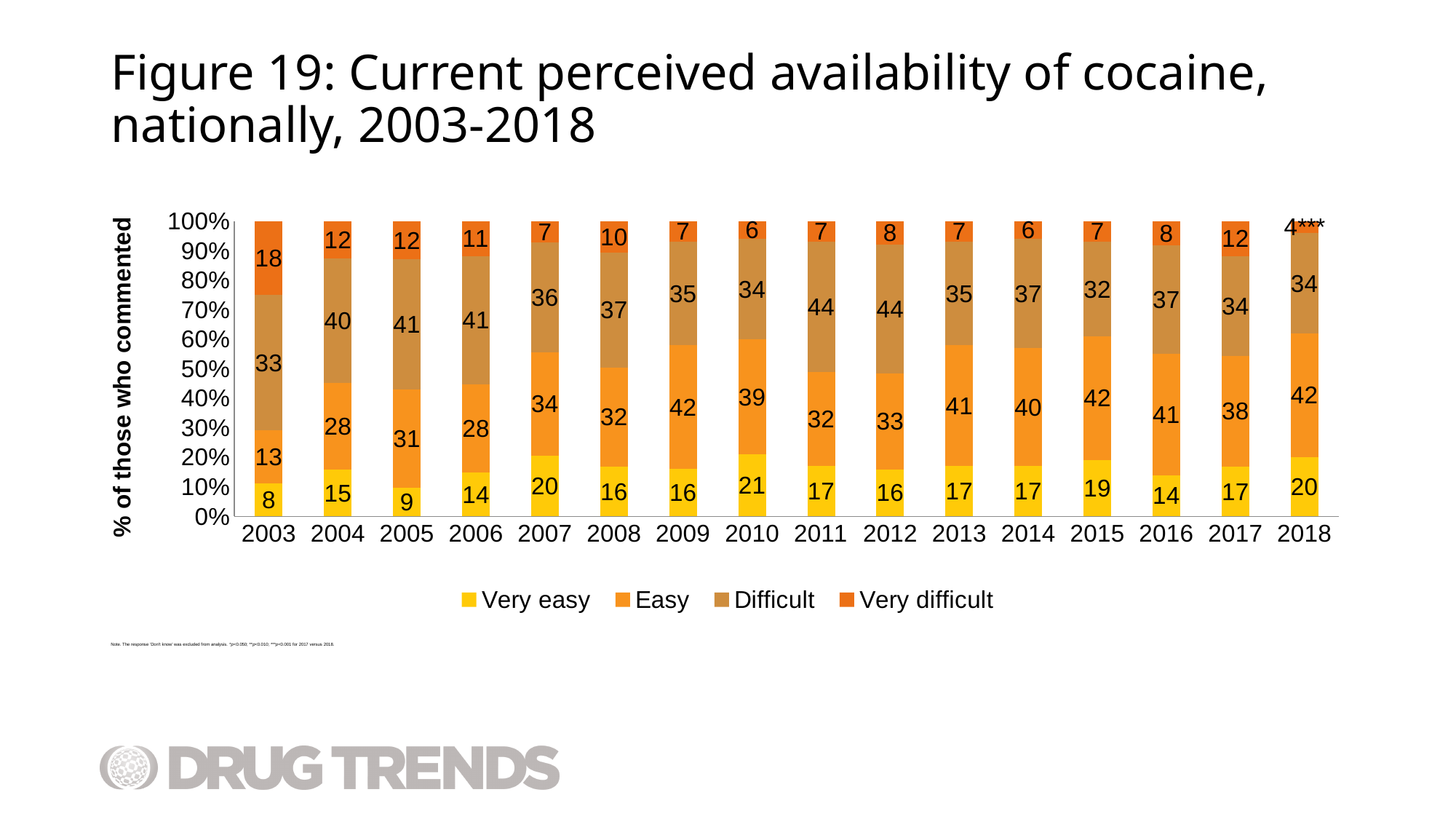
What kind of chart is shown on the slide? Stacked bar chart How many years are shown on the x axis? 16 What is the difference between the Easy values for 2018 and 2017? 4 Which year has the larger Difficult value, 2011 or 2013? 2011 What is the value for Difficult in 2012? 44 What is the title of the y axis? % of those who commented What is the value for Very easy in 2010? 21 Which year has the highest value for Very easy? 2010 Which year has the lowest value for Very easy? 2003 How many series does the legend list? 4 What is the value for Very difficult in 2003? 18 Which year has the lowest value for Very difficult? 2018